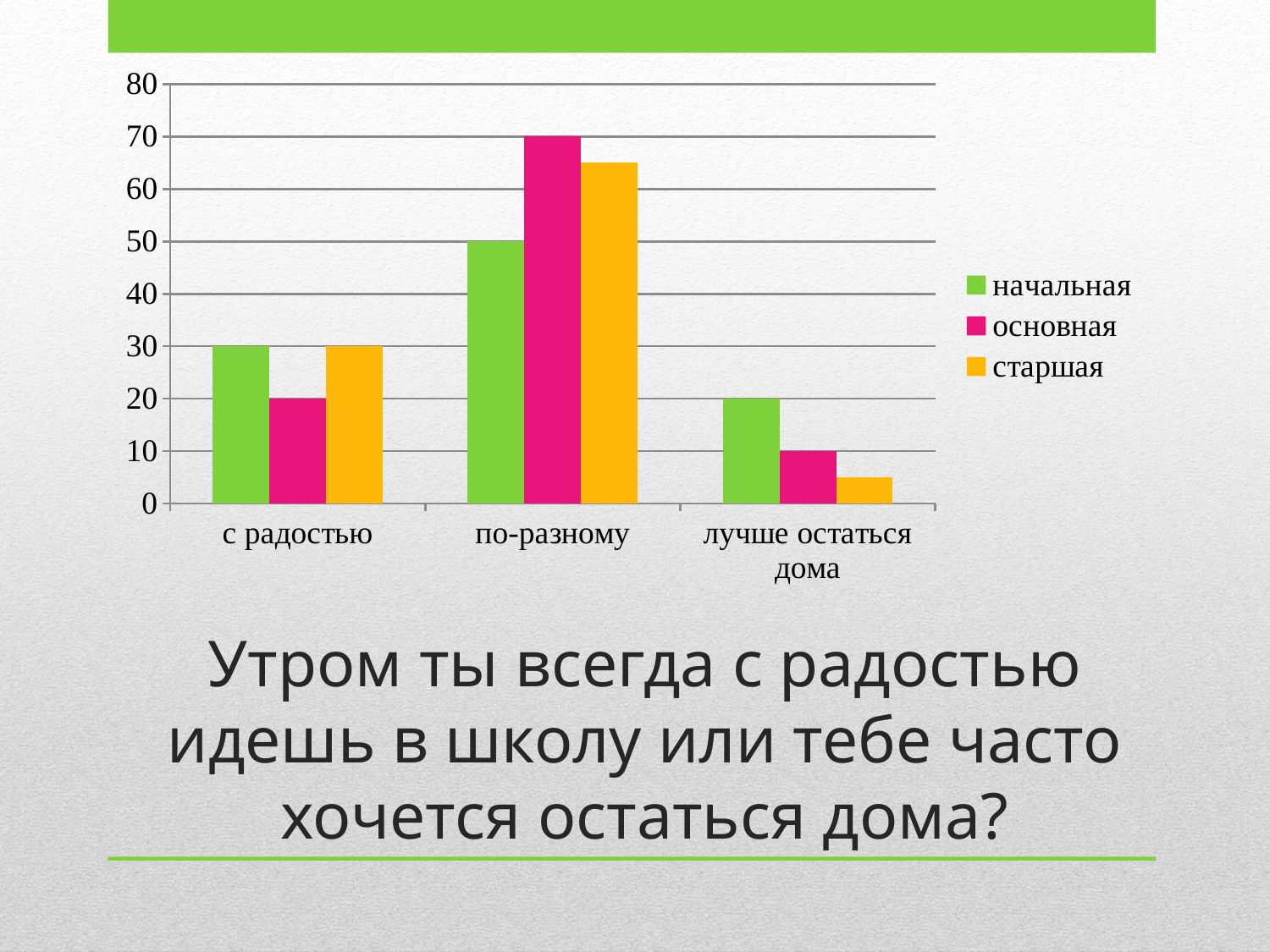
How many categories are shown on the x axis? 3 Which is larger in the category с радостью: начальная or основная? начальная What is the value for начальная in the category по-разному? 50 How many series does the legend list? 3 What is the value for начальная in the category с радостью? 30 What is the value for основная in the category лучше остаться дома? 10 Is the value for старшая in the category по-разному greater or less than 60? greater What kind of chart is shown on the slide? bar chart Which series has the lowest value in the category лучше остаться дома? старшая Is the value for старшая in the category лучше остаться дома greater or less than 10? less Which category has the highest value for the основная series? по-разному What is the value for основная in the category по-разному? 70